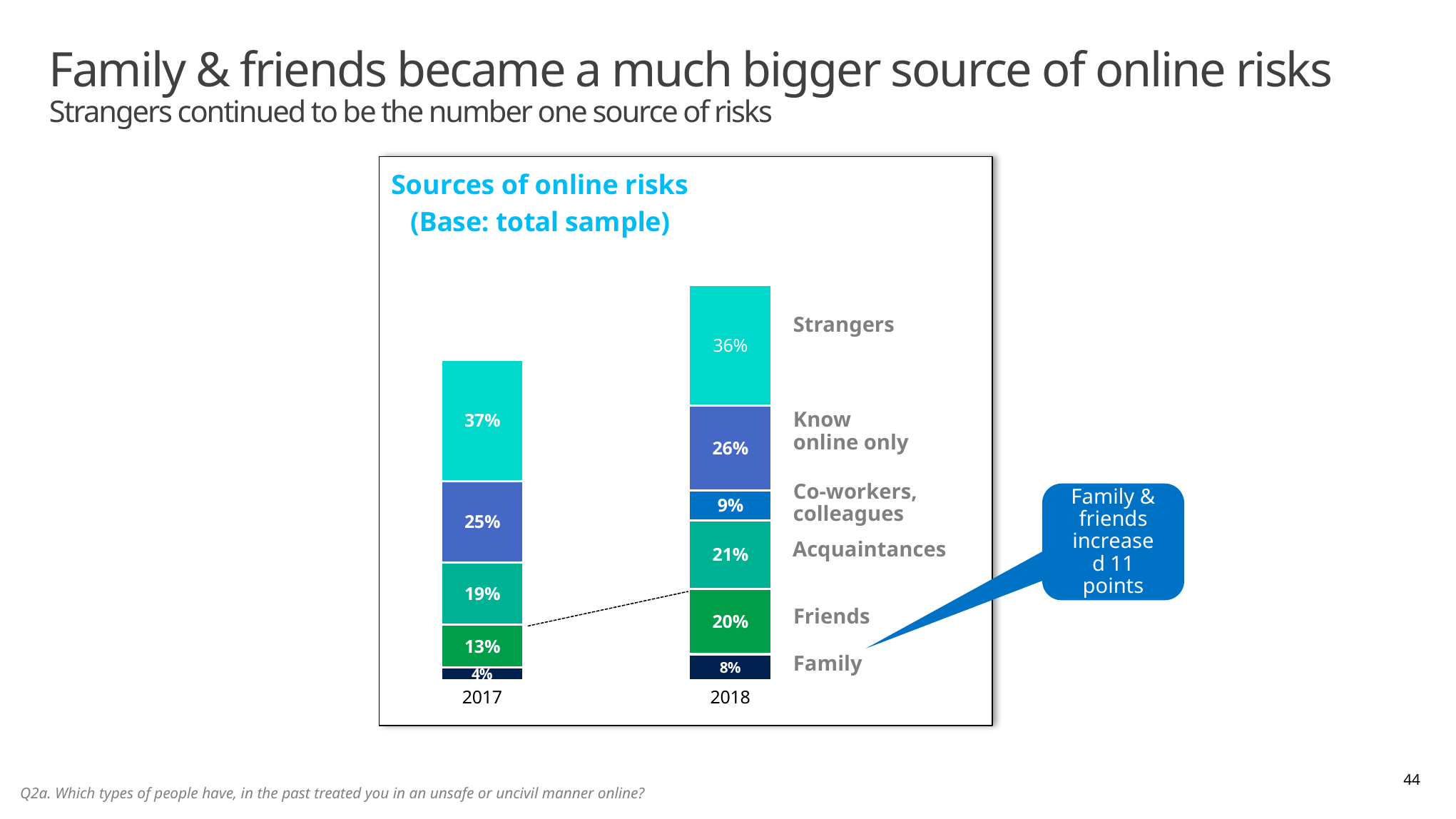
What percentage is shown for Strangers in 2018? 36% What type of chart is shown on the slide? Stacked bar chart What is the total of all segments in the 2018 bar? 120% What is the value for Co-workers, colleagues in 2018? 9% What is the value of the Family segment in the 2017 bar? 4% Which source has the smallest segment in the 2017 bar? Family By how many percentage points did the Family segment change from 2017 to 2018? 4 percentage points What percentage is shown for Friends in 2018? 20% Which source has the largest segment in the 2018 bar? Strangers Is the Friends value larger in 2017 or in 2018? 2018 How many bars are plotted in the chart? 2 What is the value for Acquaintances in 2017? 19%